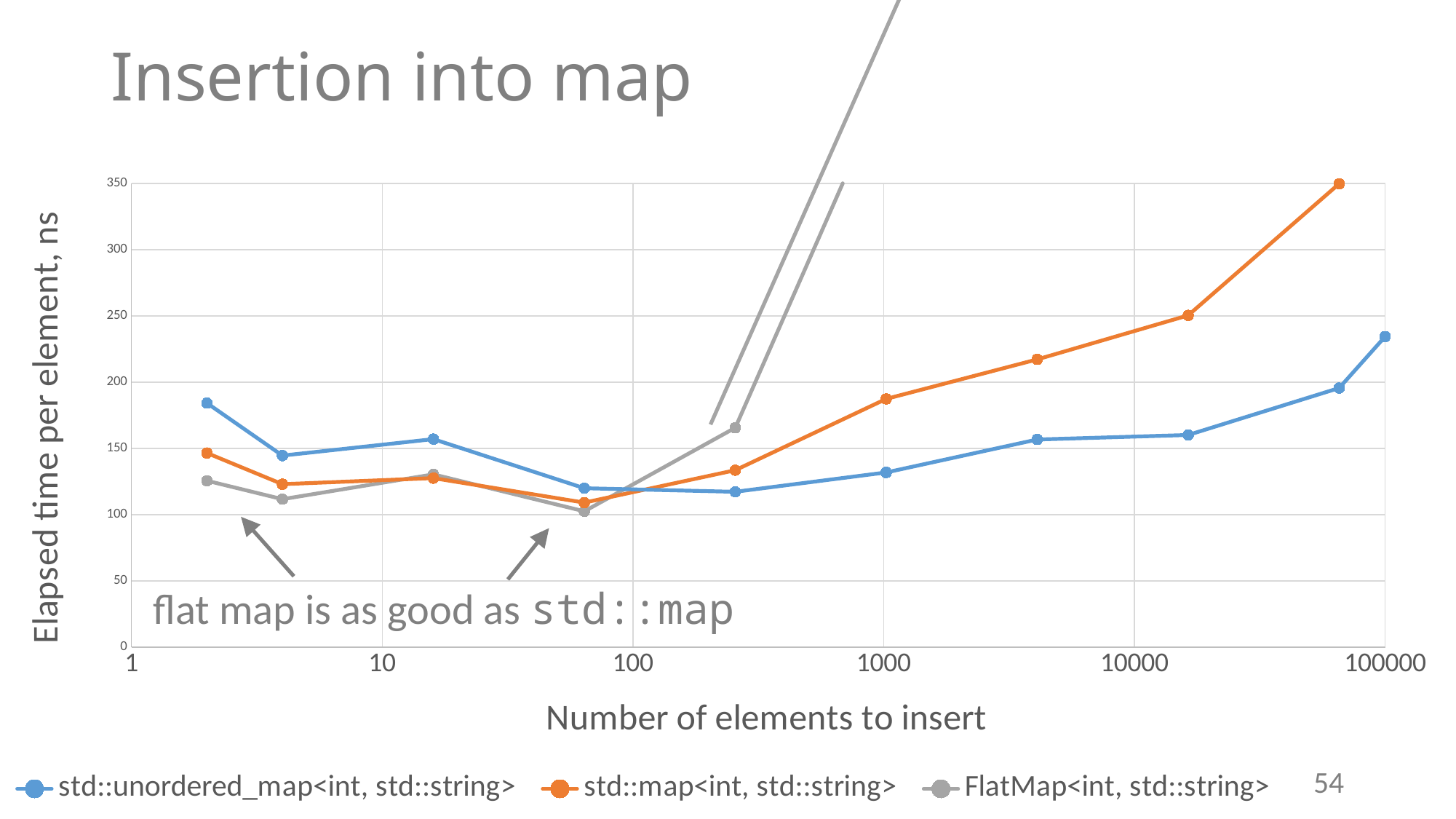
At the left end of the chart, which series has the higher elapsed time: std::unordered_map<int, std::string> or std::map<int, std::string>? std::unordered_map<int, std::string> Which series has the highest value at the right end of the chart? FlatMap<int, std::string> Is the lowest point of the FlatMap<int, std::string> series greater or less than 150? less Is the value of the rightmost point of the std::map<int, std::string> series greater or less than 300? greater At the right end of the chart (100000 elements), which series has the higher elapsed time: std::map<int, std::string> or std::unordered_map<int, std::string>? std::map<int, std::string> What is the label of the y axis? Elapsed time per element, ns Does the std::map<int, std::string> series rise or fall as the number of elements increases from 100 to 100000? rise Is the value of the rightmost point of the std::unordered_map<int, std::string> series greater or less than 250? less How many series does the legend list? 3 What is the title of the chart? Insertion into map What kind of chart is shown on the slide? line chart